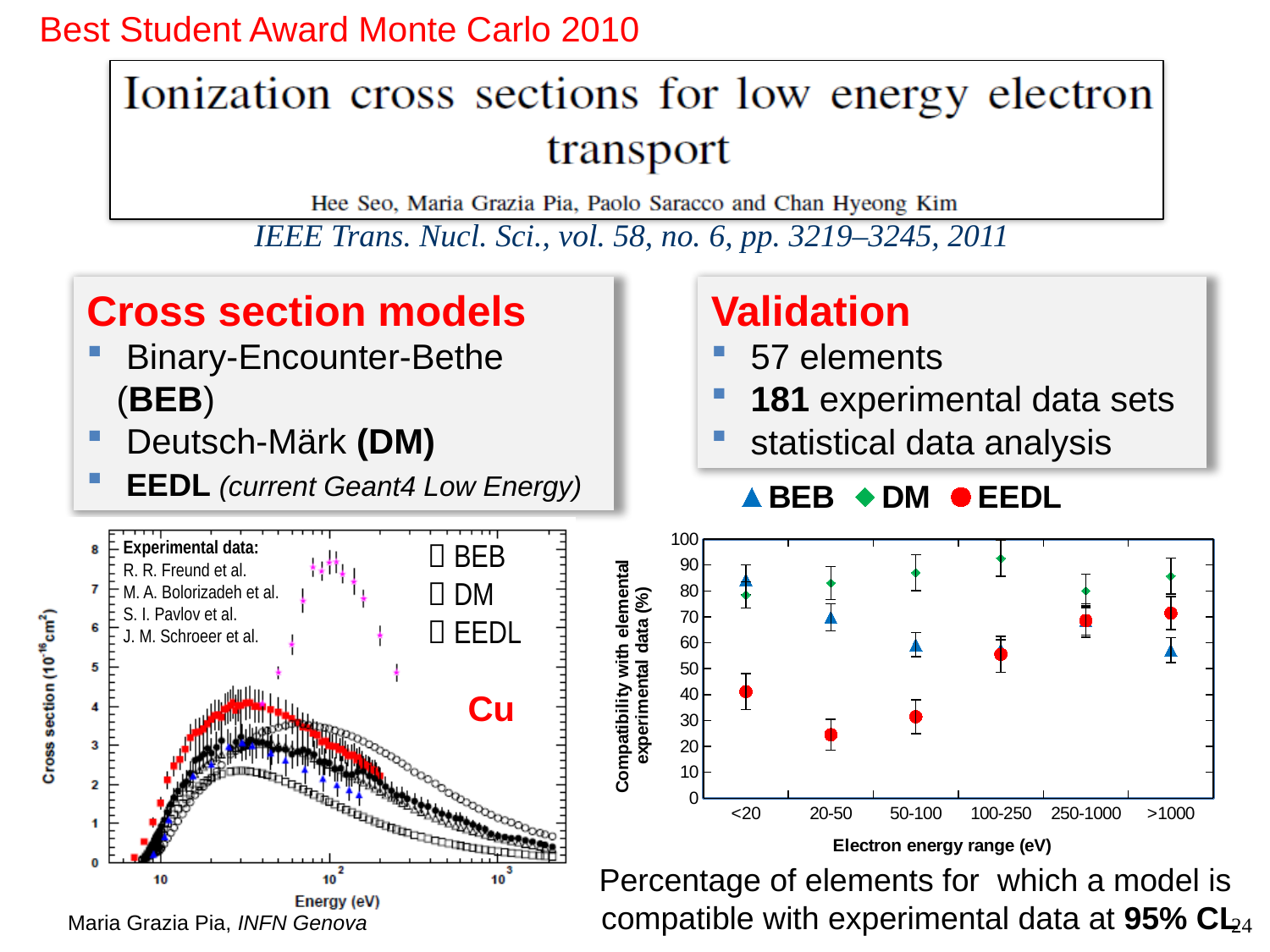
In the right chart, for the 20-50 eV range, which series has the larger value, DM or EEDL? DM In the right chart, is the EEDL value for the 20-50 eV range greater or less than 30? less Which element is the left chart (cross section vs energy) for? Cu In the right chart, in which electron energy range does the EEDL series have its lowest value? 20-50 In the right chart, does the EEDL series rise or fall from the 20-50 eV range to the >1000 eV range? rise In the right chart (Compatibility with elemental experimental data), how many electron energy ranges are shown on the x axis? 6 In the right chart, is the DM value for the 100-250 eV range greater or less than 80? greater In the right chart, in which electron energy range does the DM series reach its highest value? 100-250 In the right chart (Compatibility with elemental experimental data), how many series does the legend list? 3 What is the x-axis title of the right chart? Electron energy range (eV) What kind of chart is the right chart (Compatibility with elemental experimental data)? Scatter chart In the right chart, is the BEB value for the <20 eV range greater or less than 70? greater